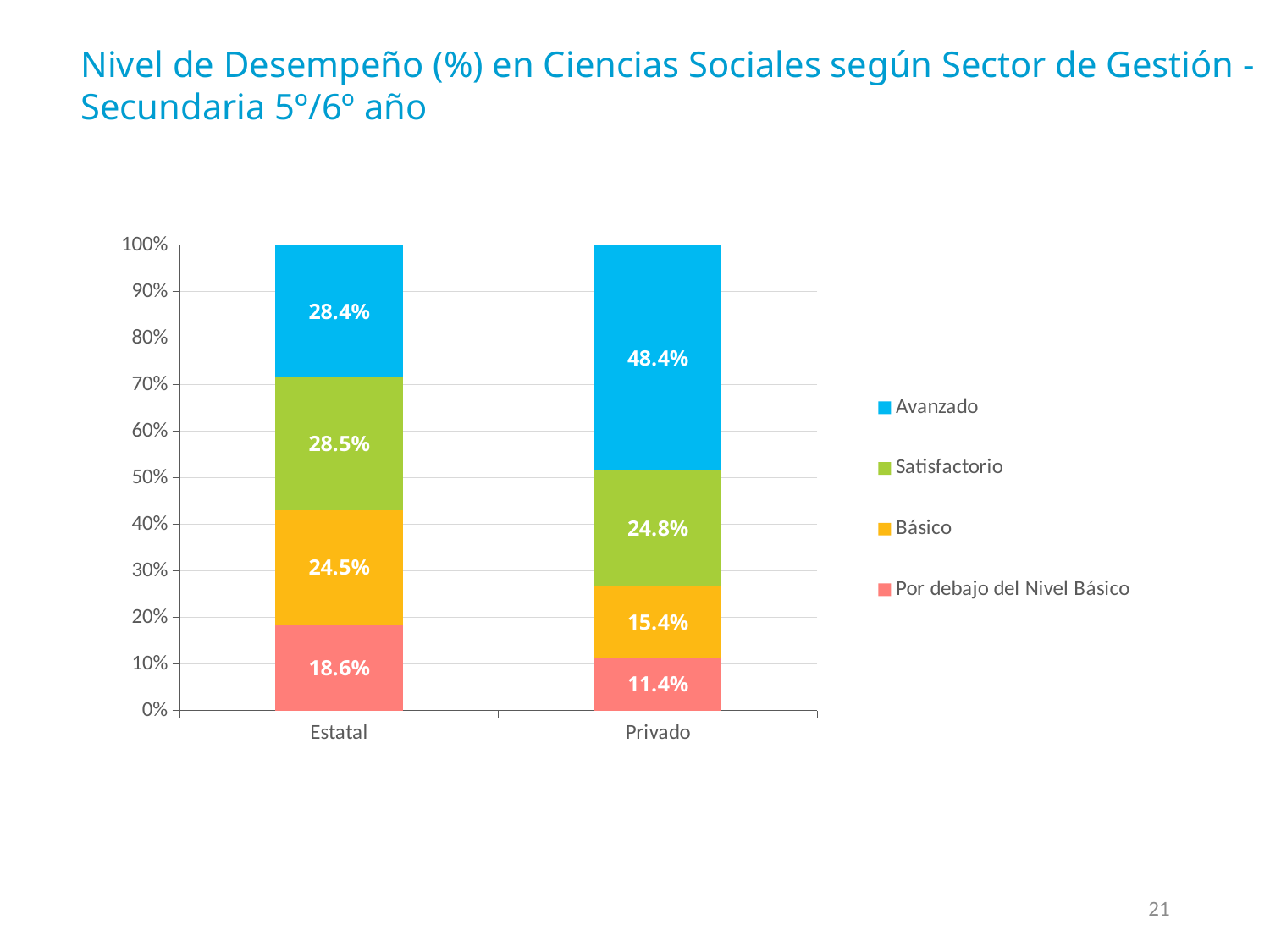
What is the Satisfactorio value for Estatal? 28.5% What is the difference between the Básico values for Estatal and Privado? 9.1% Which colour represents Satisfactorio in the legend? Green What kind of chart is shown? Stacked bar chart Which sector has the lower Por debajo del Nivel Básico value? Privado How many series does the legend list? 4 What is the Por debajo del Nivel Básico value for Estatal? 18.6% How many sectors are shown on the x axis? 2 What is the difference between the Avanzado values for Privado and Estatal? 20.0% Which sector has the higher Avanzado value? Privado What is the Básico value for Privado? 15.4% What is the Avanzado value for Privado? 48.4%